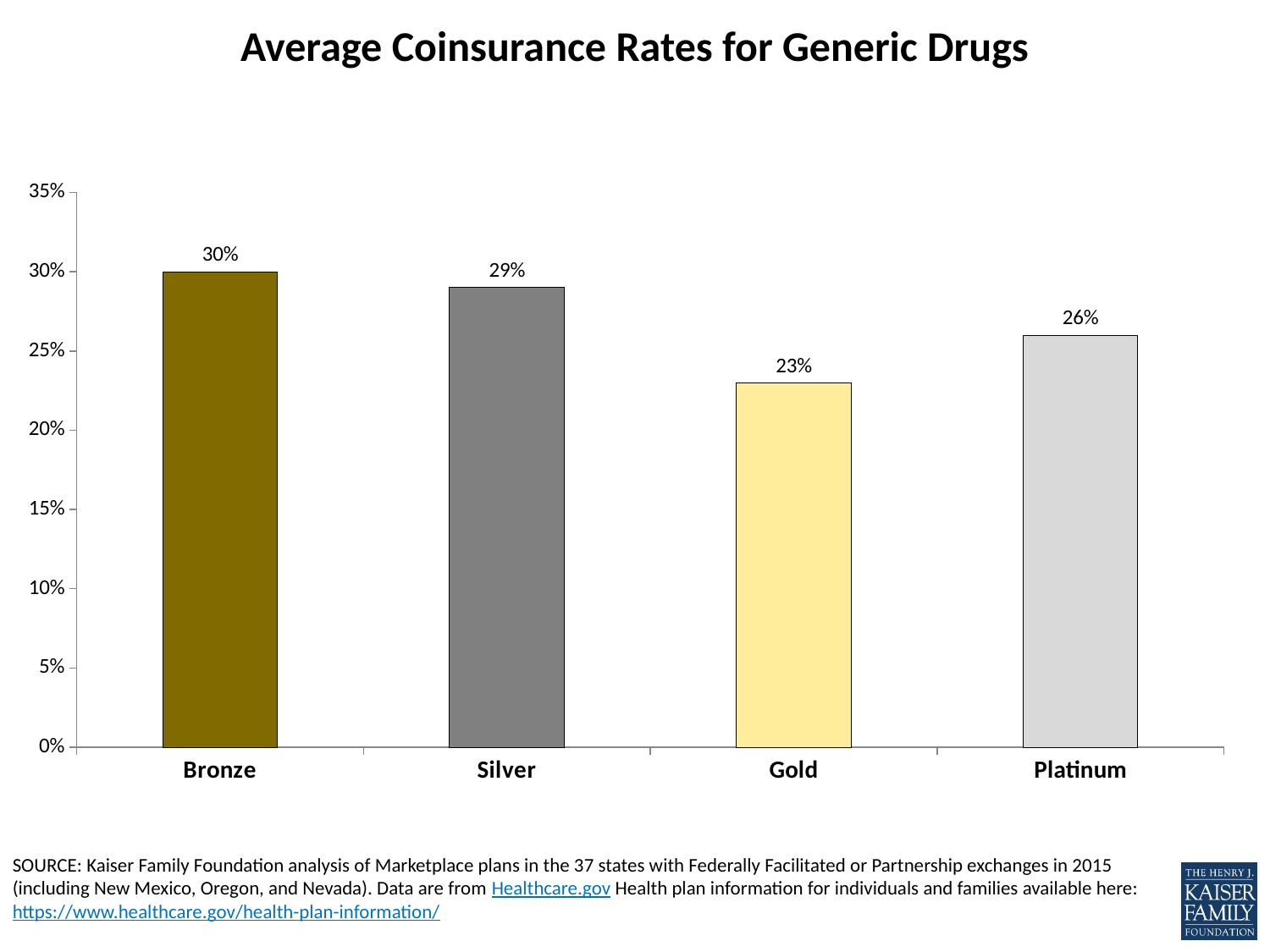
Is the value for Gold greater or less than 25%? less What is the difference between the Platinum and Gold average coinsurance rates? 3% Which has a higher average coinsurance rate, Silver or Platinum? Silver Which plan tier has the lowest average coinsurance rate for generic drugs? Gold What is the difference between the Bronze and Gold average coinsurance rates? 7% How many plan tiers are shown on the chart? 4 What is the average coinsurance rate for generic drugs for Gold plans? 23% What is the average coinsurance rate for generic drugs for Bronze plans? 30% Which plan tier has the highest average coinsurance rate for generic drugs? Bronze What is the average coinsurance rate for generic drugs for Platinum plans? 26% What is the average coinsurance rate for generic drugs for Silver plans? 29% What kind of chart is shown on the slide? Bar chart